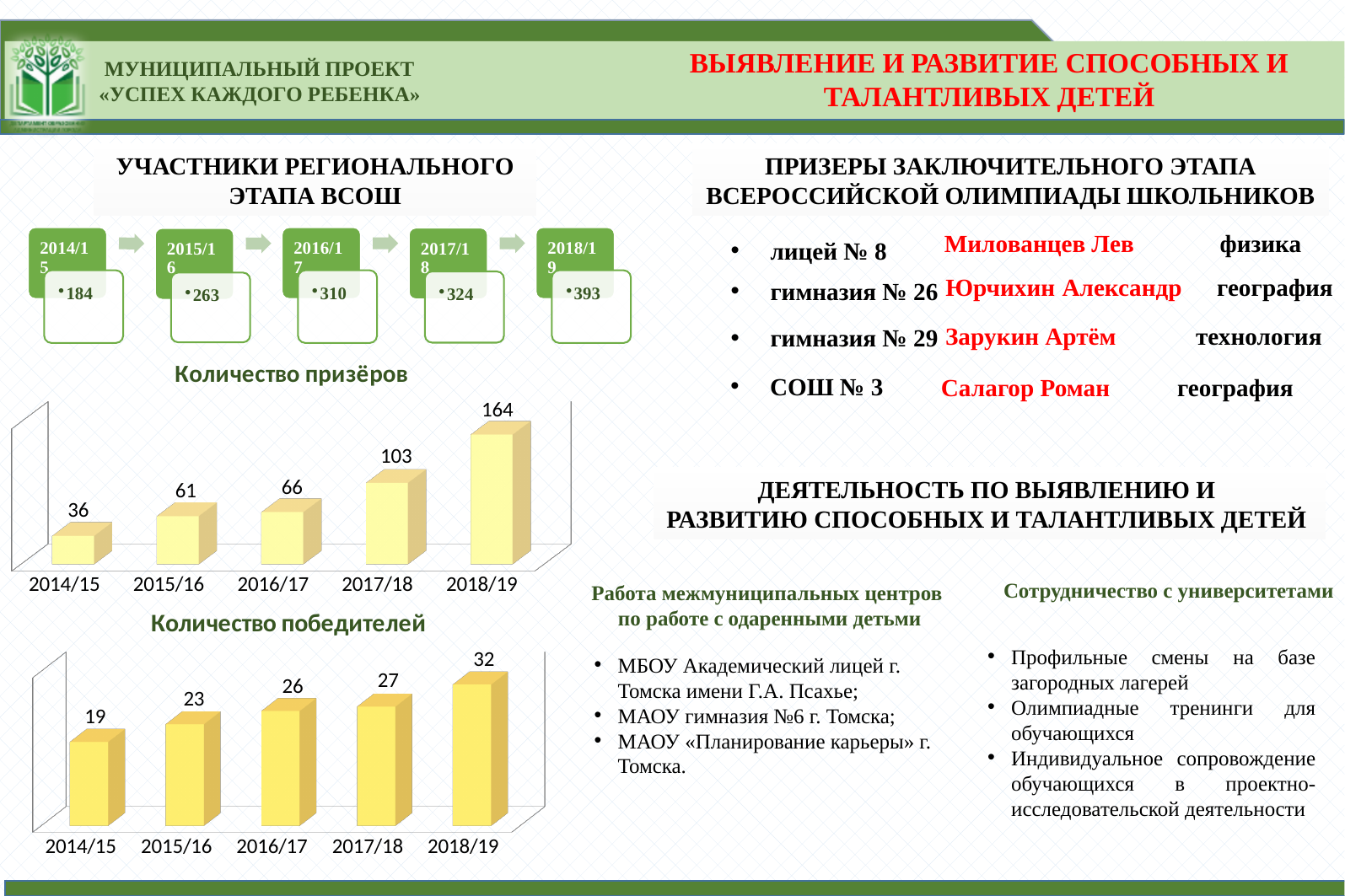
What kind of chart is the "Количество победителей" chart? bar chart In the "Количество победителей" chart, what is the difference between 2018/19 and 2014/15? 13 In the "Количество призёров" chart, what is the value for 2018/19? 164 In the "Количество призёров" chart, how many categories are shown on the x axis? 5 What is the title of the upper chart on the left side of the slide? Количество призёров In the "Количество призёров" chart, which year has the highest value? 2018/19 In the "Количество призёров" chart, what is the difference between 2018/19 and 2017/18? 61 In the "Количество призёров" chart, what is the value for 2014/15? 36 In the "Количество победителей" chart, which is larger: the value for 2015/16 or the value for 2018/19? 2018/19 In the "Количество победителей" chart, what is the value for 2016/17? 26 In the "Количество победителей" chart, which year has the lowest value? 2014/15 In the "Количество призёров" chart, do the values rise or fall from 2014/15 to 2018/19? rise